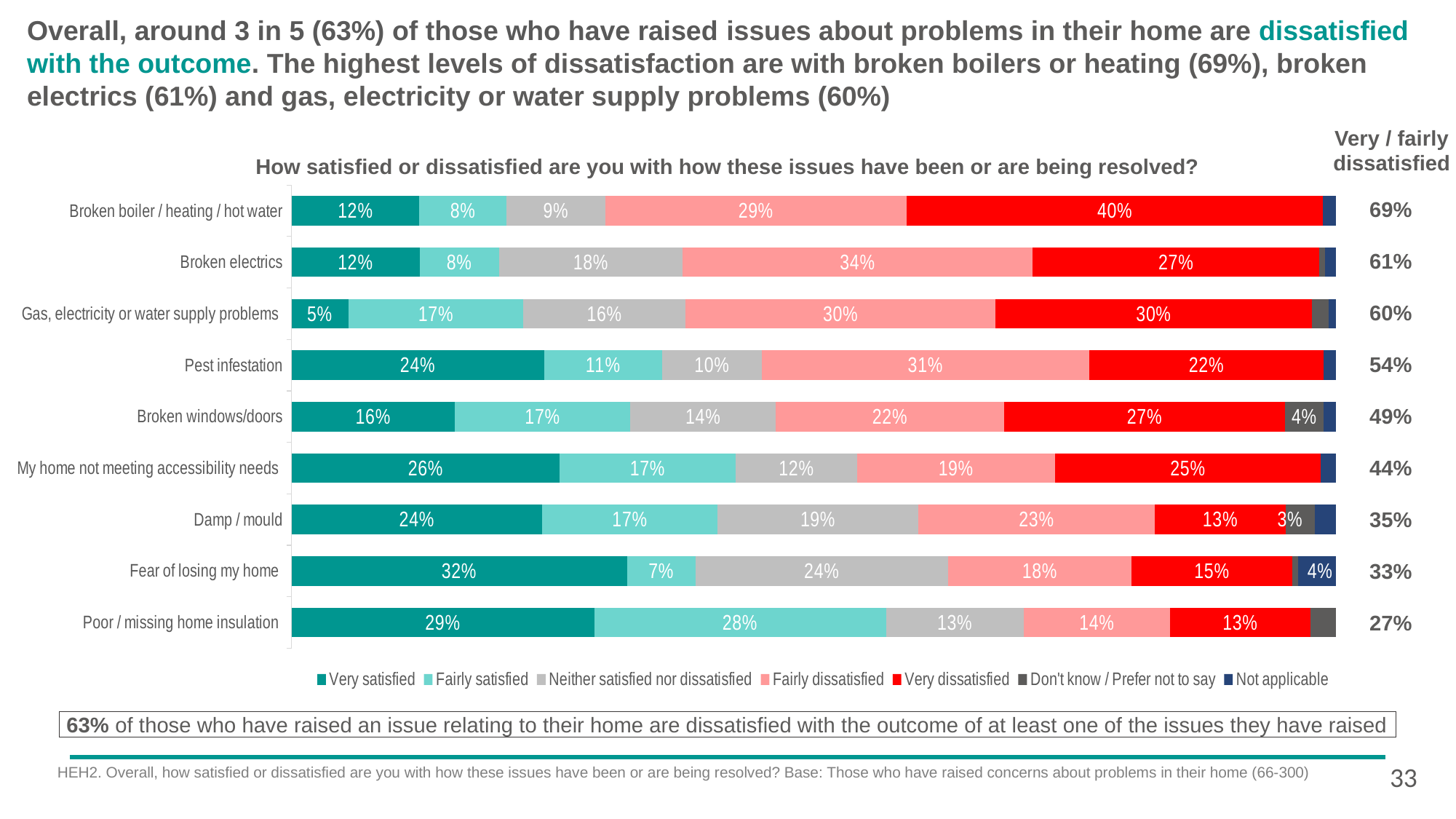
Which issue has the highest 'Very dissatisfied' percentage? Broken boiler / heating / hot water Which issue has the lowest 'Very / fairly dissatisfied' figure? Poor / missing home insulation What is the difference between the 'Very / fairly dissatisfied' figures for Broken boiler / heating / hot water and Broken electrics? 8 percentage points Which has a higher 'Fairly dissatisfied' percentage: Broken electrics or Damp / mould? Broken electrics How many series does the legend list? 7 How many issue categories are shown in the chart? 9 What type of chart is shown on the slide? Stacked bar chart What colour represents 'Very dissatisfied' in the chart? Red What percentage of respondents with a broken boiler / heating / hot water issue are very dissatisfied with how it is being resolved? 40% Which issue has the lowest 'Very satisfied' percentage? Gas, electricity or water supply problems What is the 'Very / fairly dissatisfied' figure shown for Pest infestation? 54% What percentage of respondents with a fear of losing their home are very satisfied with how the issue is being resolved? 32%